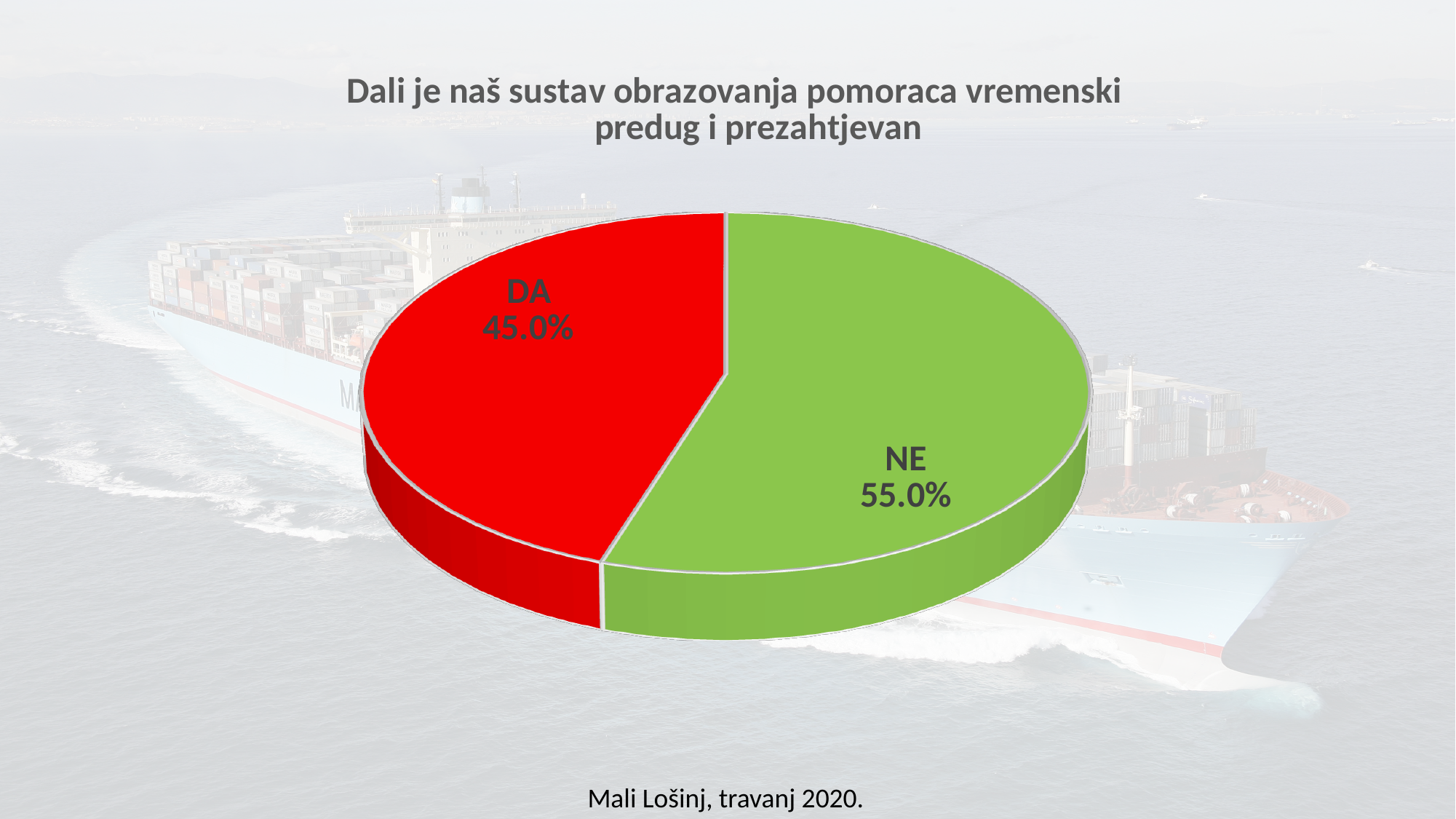
What is the difference in percentage points between the NE slice and the DA slice? 10.0% How many slices does the pie chart have? 2 Is the value for DA greater or less than 50%? less What kind of chart is shown on the slide? Pie chart Which is larger, the DA slice or the NE slice? NE Which slice is the largest in the pie chart? NE What share of the pie does the NE slice represent? 55.0% What is the title of the chart? Dali je naš sustav obrazovanja pomoraca vremenski predug i prezahtjevan What share of the pie does the DA slice represent? 45.0% Which slice is the smallest in the pie chart? DA What colour is the DA slice? Red